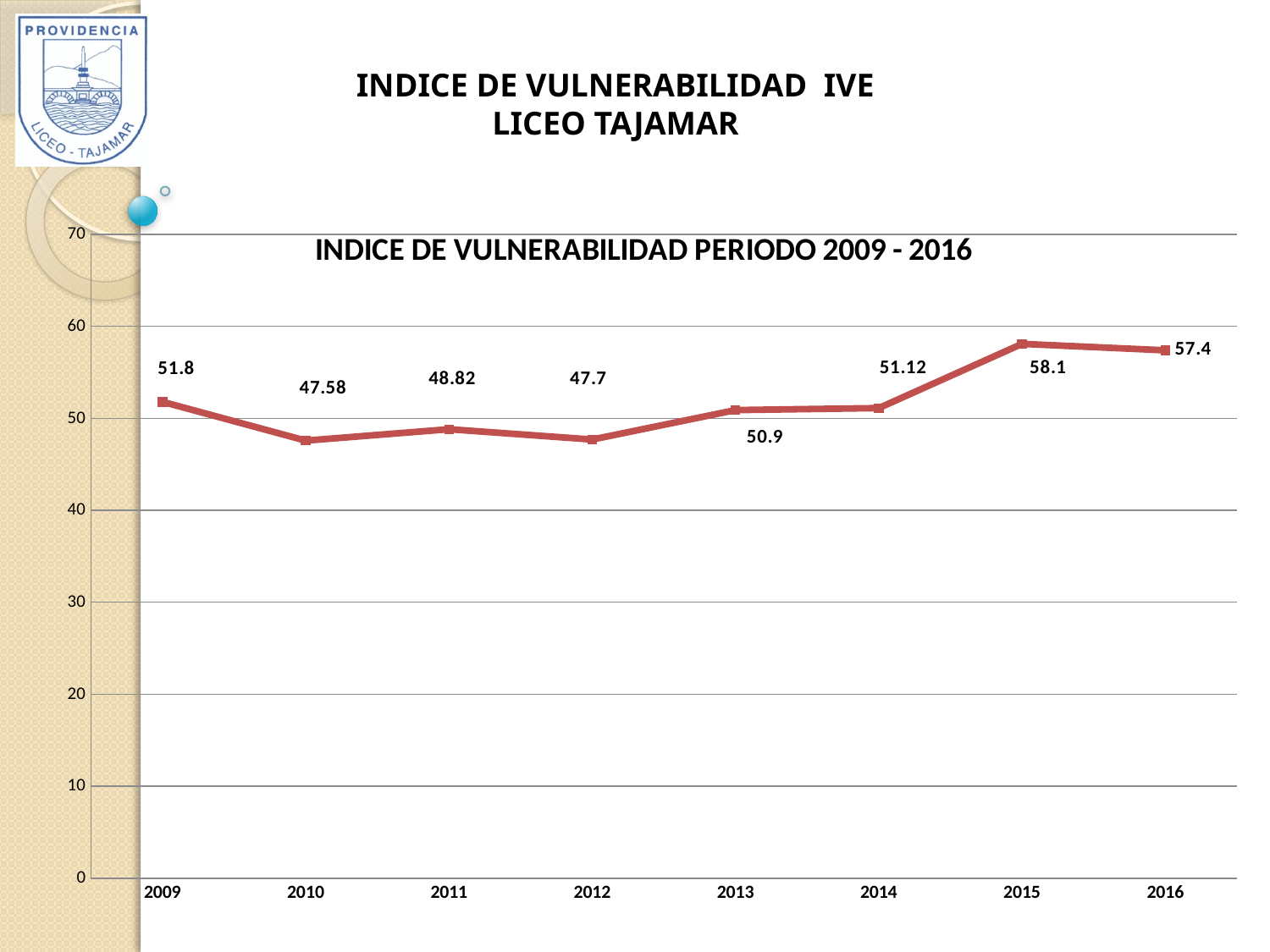
What is the value for 2015? 58.1 What is the title of the chart? INDICE DE VULNERABILIDAD PERIODO 2009 - 2016 How many years are plotted on the x axis? 8 What is the value for 2009? 51.8 What is the value for 2016? 57.4 What is the difference between the values for 2015 and 2014? 6.98 Which is larger, the value for 2011 or the value for 2013? 2013 What kind of chart is shown? line chart Is the value for 2015 greater or less than 50? greater What is the value for 2012? 47.7 Which year has the highest value? 2015 Which year has the lowest value? 2010